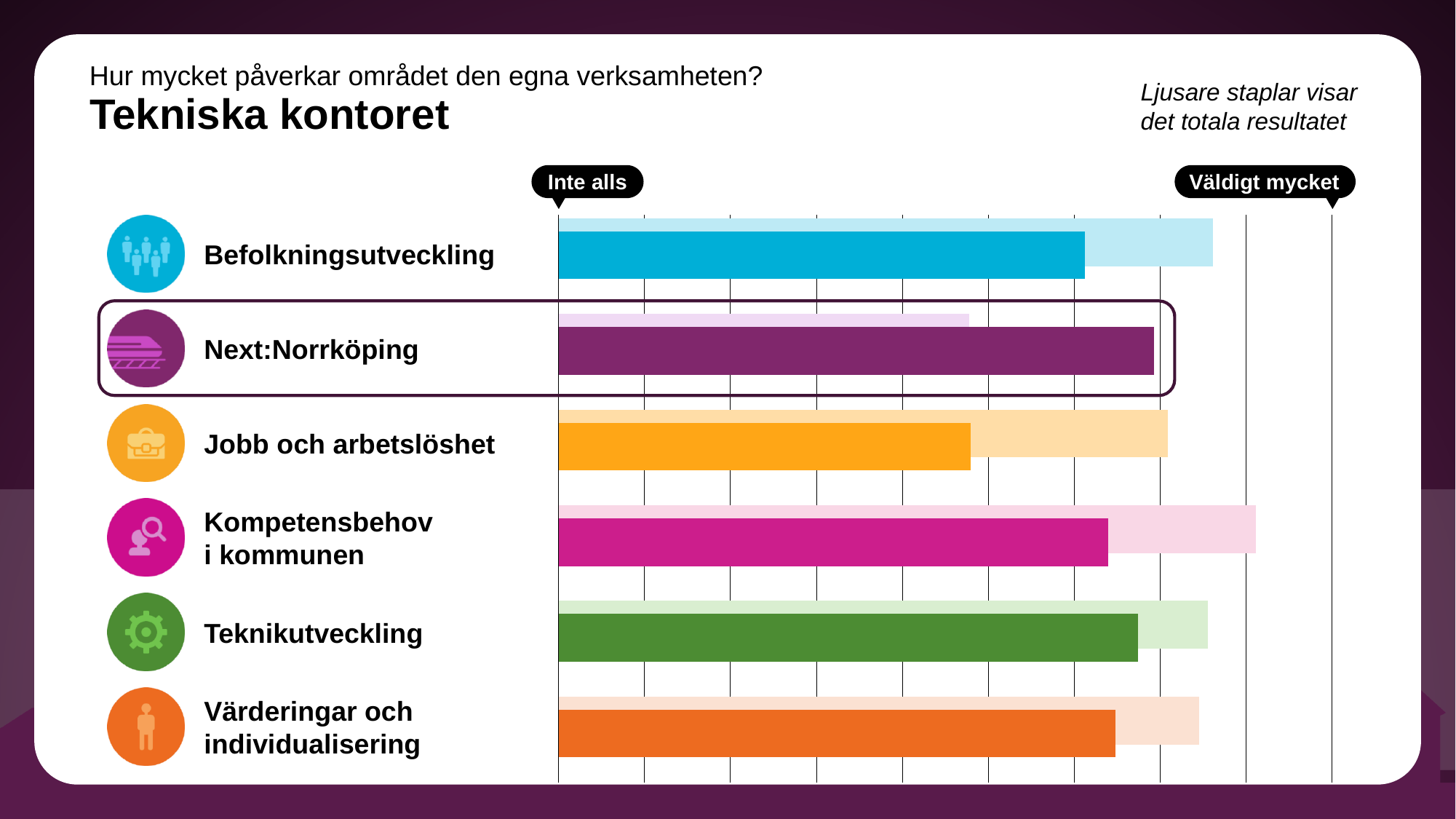
Which category has the shortest dark bar (Tekniska kontoret result)? Jobb och arbetslöshet According to the note on the slide, what do the lighter bars show? Det totala resultatet Which category has the longest dark bar (Tekniska kontoret result)? Next:Norrköping What kind of chart is shown on the slide? Bar chart Which category has the shortest light bar (total result)? Next:Norrköping Is the dark bar for Teknikutveckling longer or shorter than the dark bar for Jobb och arbetslöshet? Longer What are the labels at the two ends of the chart's axis? Inte alls and Väldigt mycket Is the dark bar for Befolkningsutveckling longer or shorter than the dark bar for Jobb och arbetslöshet? Longer Which category has the longest light bar (total result)? Kompetensbehov i kommunen How many categories (areas) are shown in the chart? 6 For which category is the dark bar longer than the light bar? Next:Norrköping